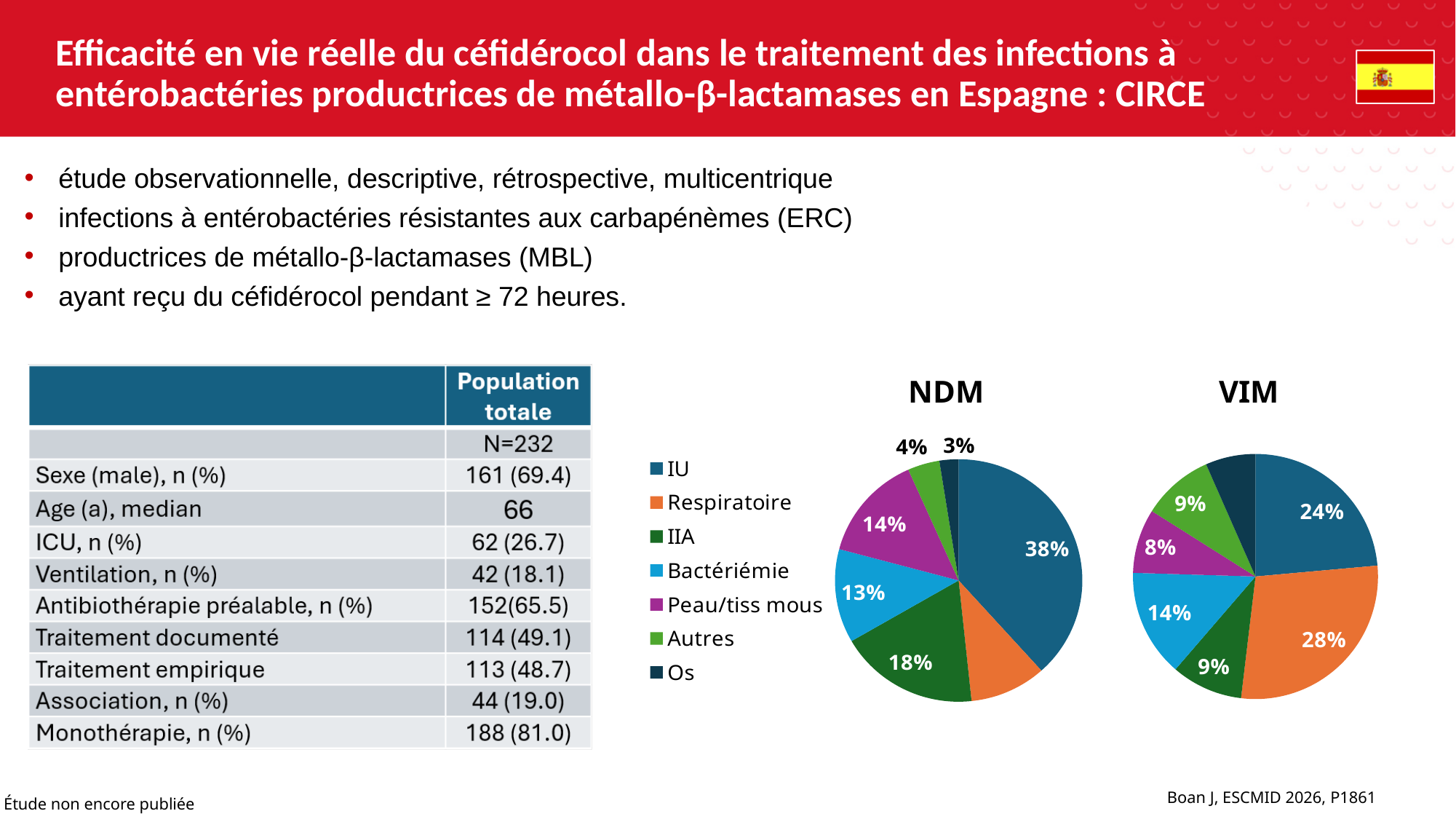
In the NDM pie chart, what share is labelled for IU? 38% In the VIM pie chart, which category has the largest share? Respiratoire In the NDM pie chart, which category has the largest share? IU How many categories does the legend shared by the NDM and VIM pie charts list? 7 In the NDM pie chart, what share is labelled for Os? 3% In the NDM pie chart, what share is labelled for IIA? 18% In the VIM pie chart, what share is labelled for IU? 24% In the NDM pie chart, what share is labelled for Peau/tiss mous? 14% In the VIM pie chart, what share is labelled for Bactériémie? 14% In the NDM pie chart, what is the difference between the IU share and the IIA share? 20% In the VIM pie chart, what share is labelled for Respiratoire? 28% What kind of chart is the NDM chart? pie chart